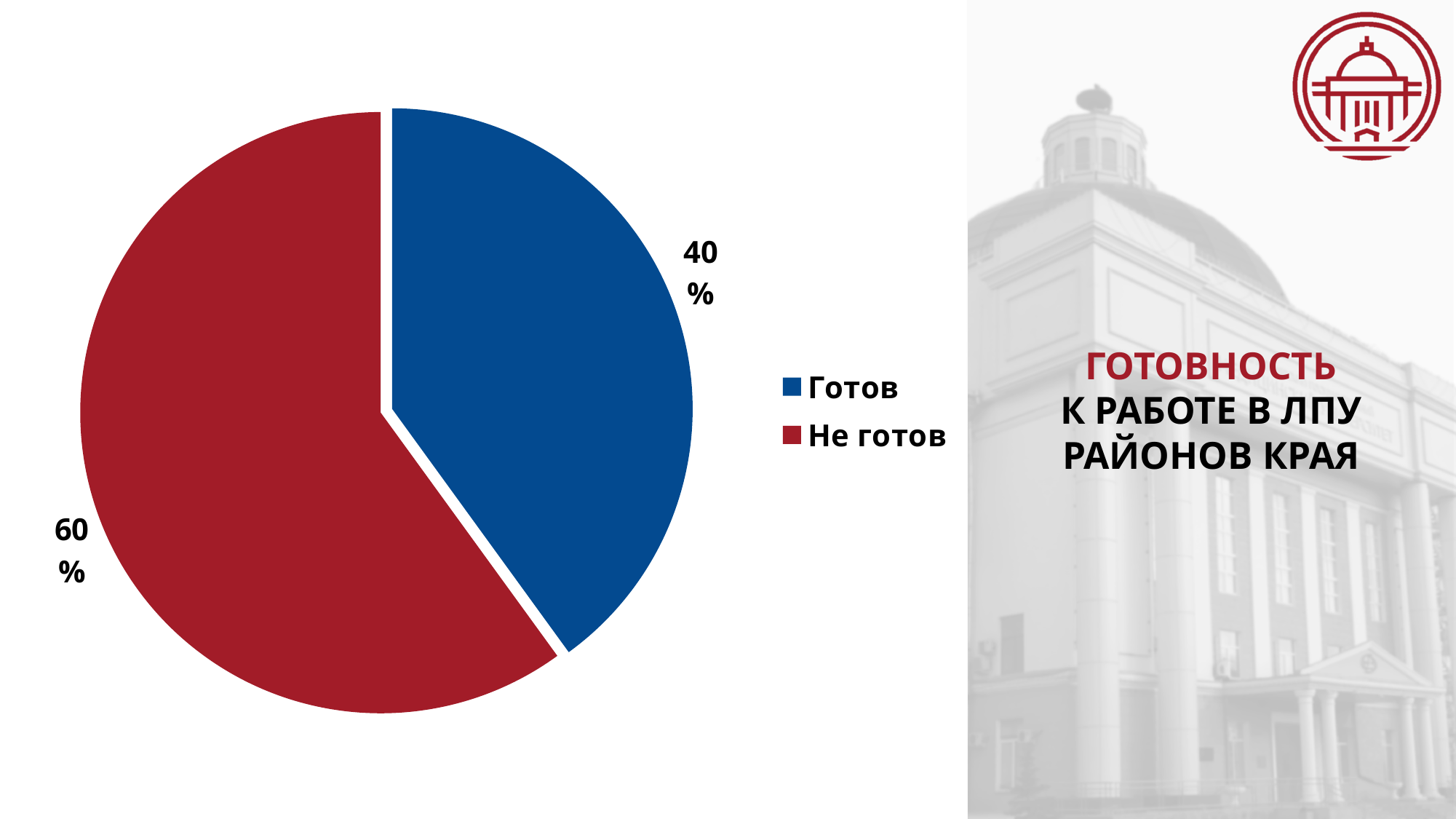
What colour is the slice for "Не готов"? red What kind of chart is shown on the slide? pie chart What share of the pie does "Не готов" represent? 60% Which is larger, the slice for "Готов" or the slice for "Не готов"? Не готов What colour is the slice for "Готов"? blue How many slices does the pie chart have? 2 How many entries does the legend list? 2 Which category has the smallest slice of the pie? Готов What share of the pie does "Готов" represent? 40% What is the difference in percentage points between "Не готов" and "Готов"? 20 Which category has the largest slice of the pie? Не готов